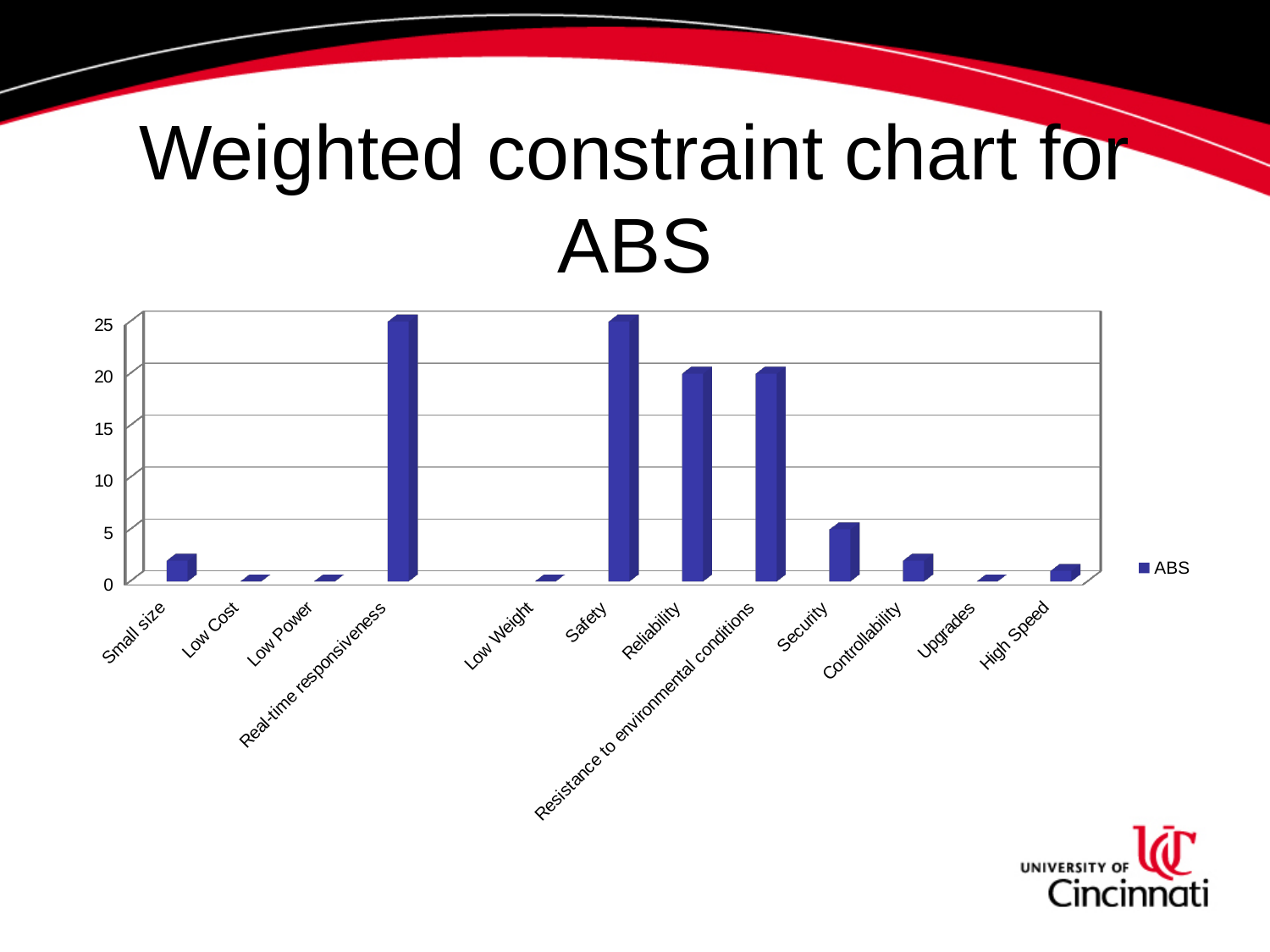
Which is larger, the value for Real-time responsiveness or the value for Security? Real-time responsiveness What is the difference between the values for Safety and Reliability? 5 What is the title of the slide containing the chart? Weighted constraint chart for ABS How many series does the legend list? 1 What is the value for Safety? 25 What is the name of the series shown in the legend? ABS What type of chart is shown on the slide? Bar chart Is the value for Small size greater or less than 5? less How many categories are shown on the x axis of the chart? 12 What is the value for Security? 5 What is the value for Reliability? 20 Is the value for Resistance to environmental conditions greater or less than 15? greater